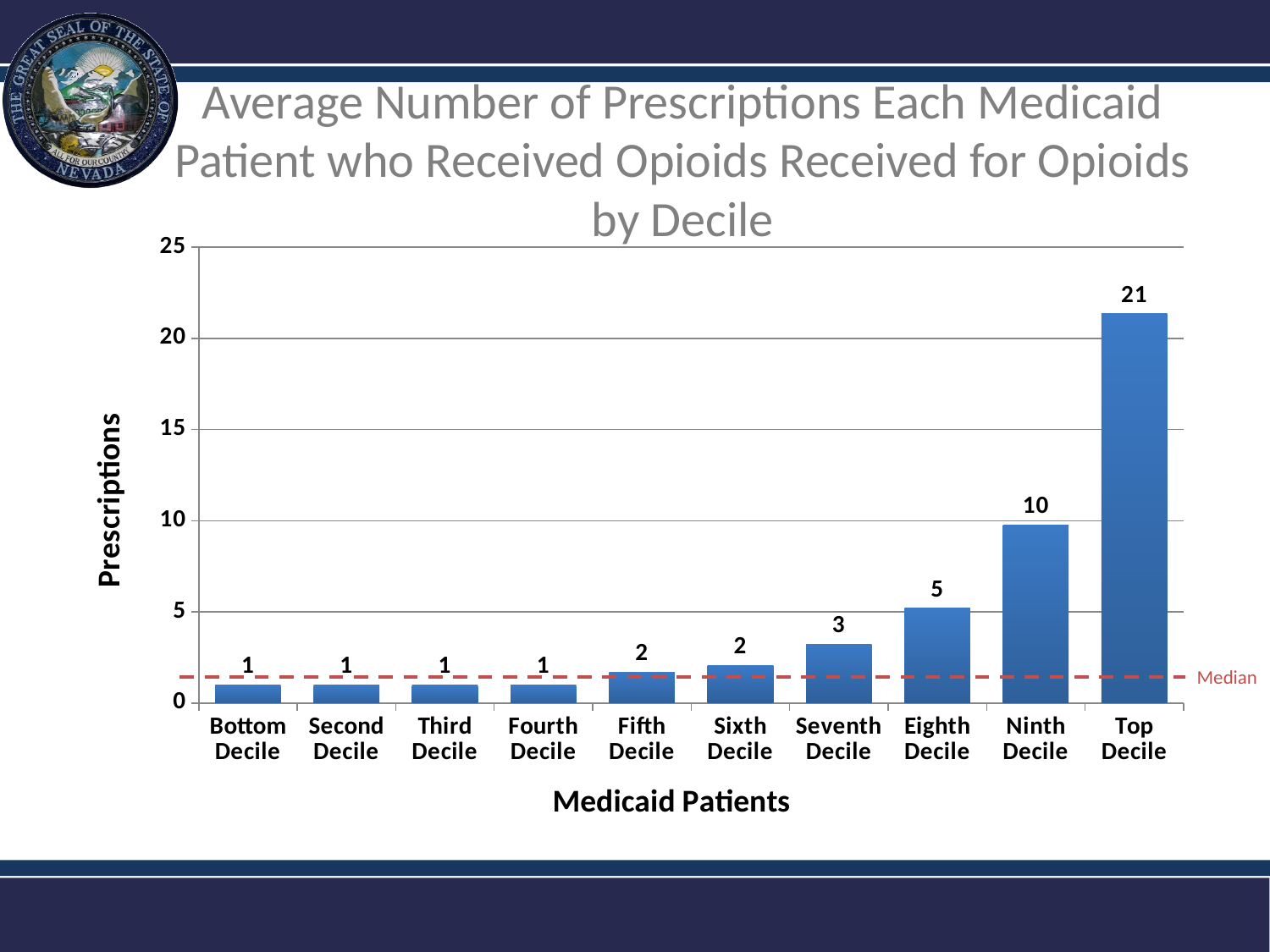
What is the difference between the values for the Top Decile and the Ninth Decile? 11 What kind of chart is shown on the slide? bar chart Is the value for the Top Decile greater or less than 20? greater What does the red dashed horizontal line represent? Median What is the value for the Seventh Decile? 3 Which is larger, the value for the Eighth Decile or the Seventh Decile? Eighth Decile Which decile has the highest average number of prescriptions? Top Decile What is the value for the Top Decile? 21 How many deciles are shown on the x axis? 10 What is the value for the Ninth Decile? 10 What is the value for the Eighth Decile? 5